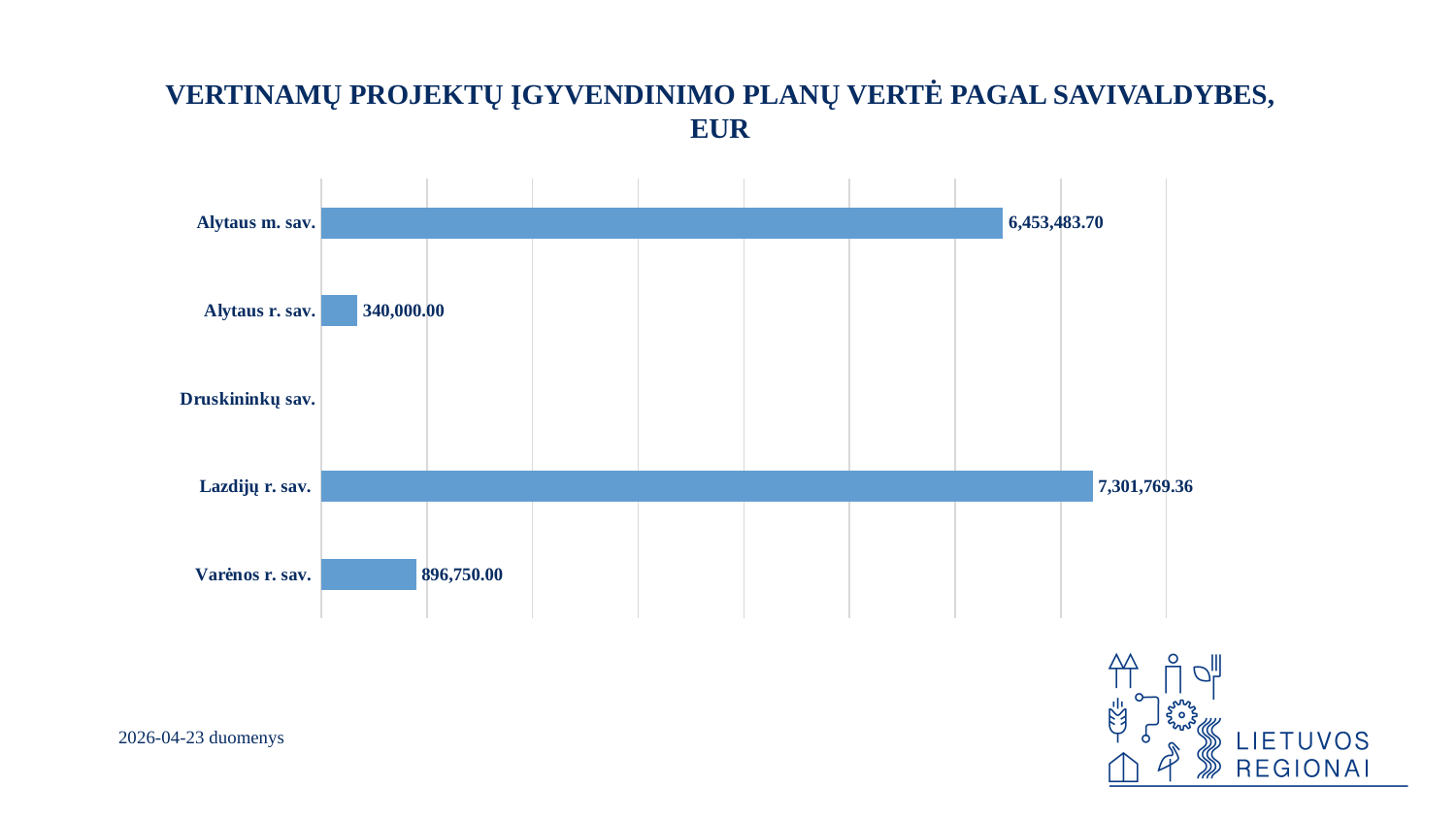
Which municipality on the chart has no bar or value shown? Druskininkų sav. Which municipality has the highest value? Lazdijų r. sav. What is the value for Alytaus m. sav.? 6,453,483.70 What is the value for Alytaus r. sav.? 340,000.00 What is the difference between the values for Lazdijų r. sav. and Alytaus m. sav.? 848,285.66 Which is larger, the value for Varėnos r. sav. or the value for Alytaus r. sav.? Varėnos r. sav. What is the value for Varėnos r. sav.? 896,750.00 What is the difference between the values for Varėnos r. sav. and Alytaus r. sav.? 556,750.00 Which municipality has the shortest bar among those with a bar shown? Alytaus r. sav. What is the value for Lazdijų r. sav.? 7,301,769.36 How many municipalities are listed on the chart? 5 What kind of chart is shown on the slide? Bar chart